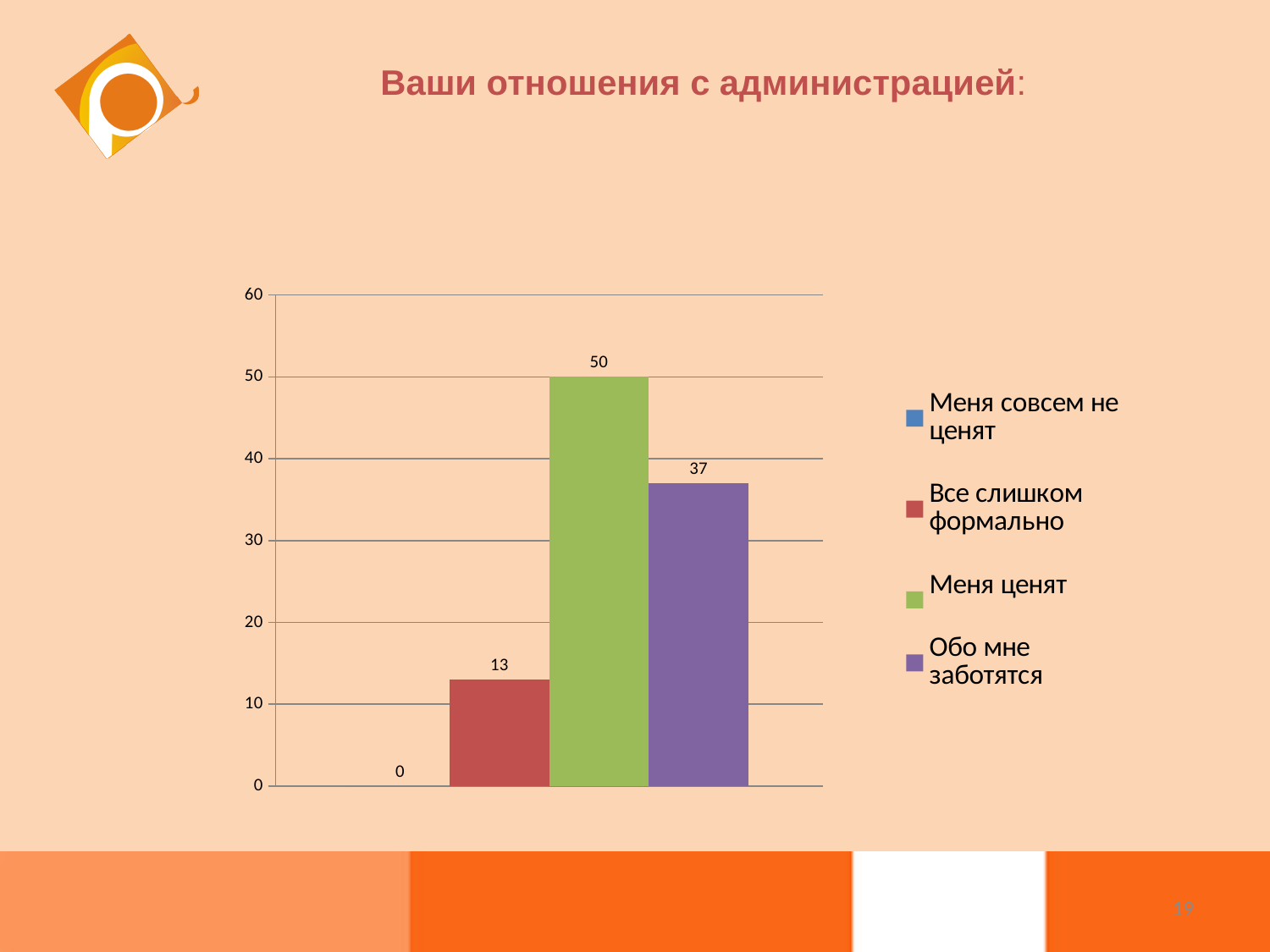
What is the difference between the values for "Меня ценят" and "Обо мне заботятся"? 13 What is the title of the slide? Ваши отношения с администрацией: What kind of chart is shown on the slide? Bar chart Which series has the highest value? Меня ценят What is the value for "Все слишком формально"? 13 What colour is the bar for "Меня ценят"? Green What is the value for "Меня ценят"? 50 Which is larger, the value for "Все слишком формально" or the value for "Обо мне заботятся"? Обо мне заботятся What is the value for "Обо мне заботятся"? 37 Which series has the lowest value? Меня совсем не ценят What is the value for "Меня совсем не ценят"? 0 How many series does the legend list? 4